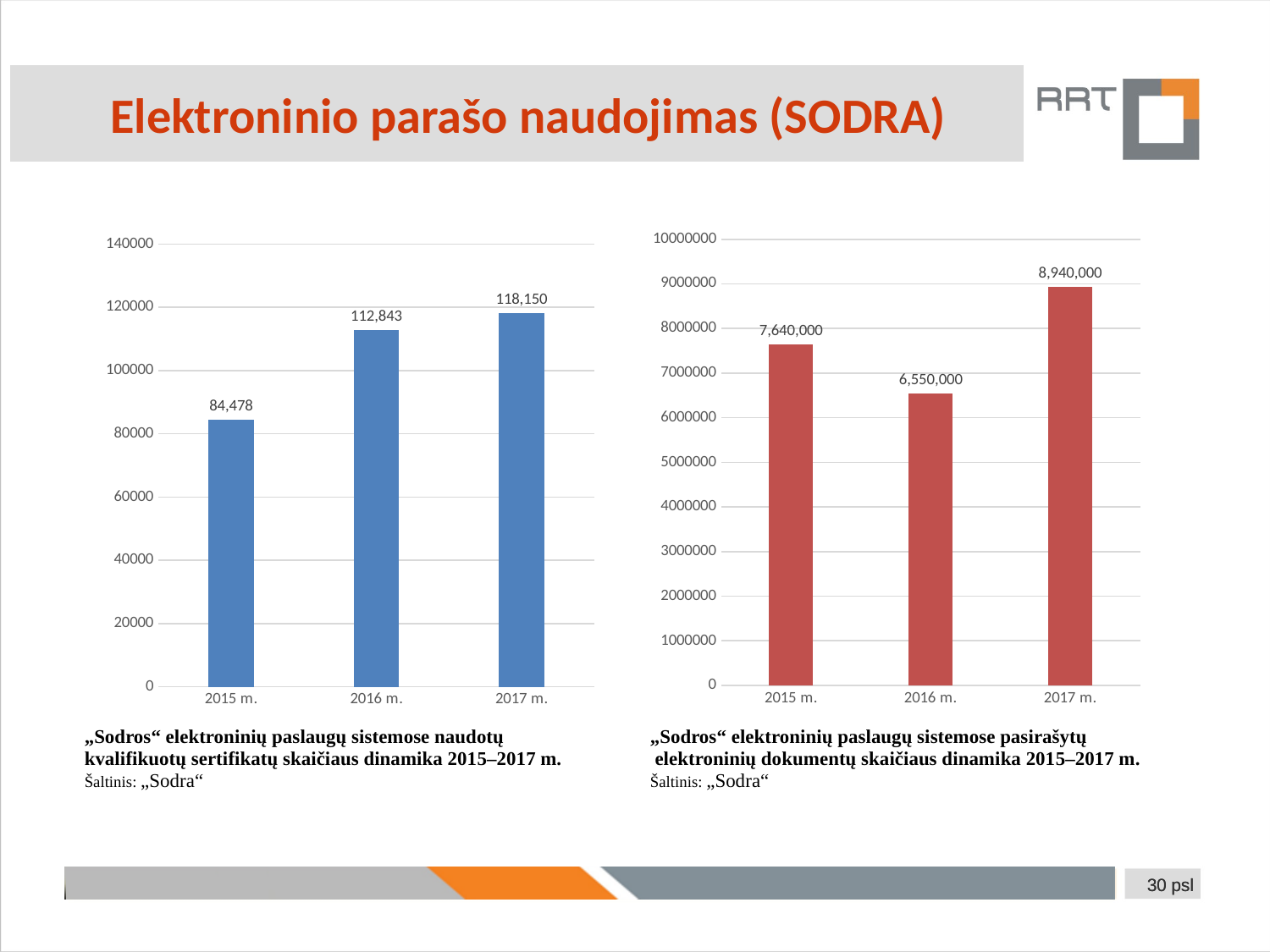
What type of chart is the left chart? bar chart In the right chart, what is the difference between the values for 2017 m. and 2016 m.? 2,390,000 In the right chart, what is the value for 2016 m.? 6,550,000 How many bars does the right chart have? 3 In the right chart, which is larger, the value for 2015 m. or 2016 m.? 2015 m. In the left chart, what is the difference between the values for 2016 m. and 2015 m.? 28,365 In the left chart, which year has the highest value? 2017 m. In the left chart, do the values rise or fall from 2015 m. to 2017 m.? rise In the right chart, what is the value for 2017 m.? 8,940,000 In the right chart, which year has the lowest value? 2016 m. In the left chart, what is the value for 2017 m.? 118,150 In the left chart, what is the value for 2015 m.? 84,478